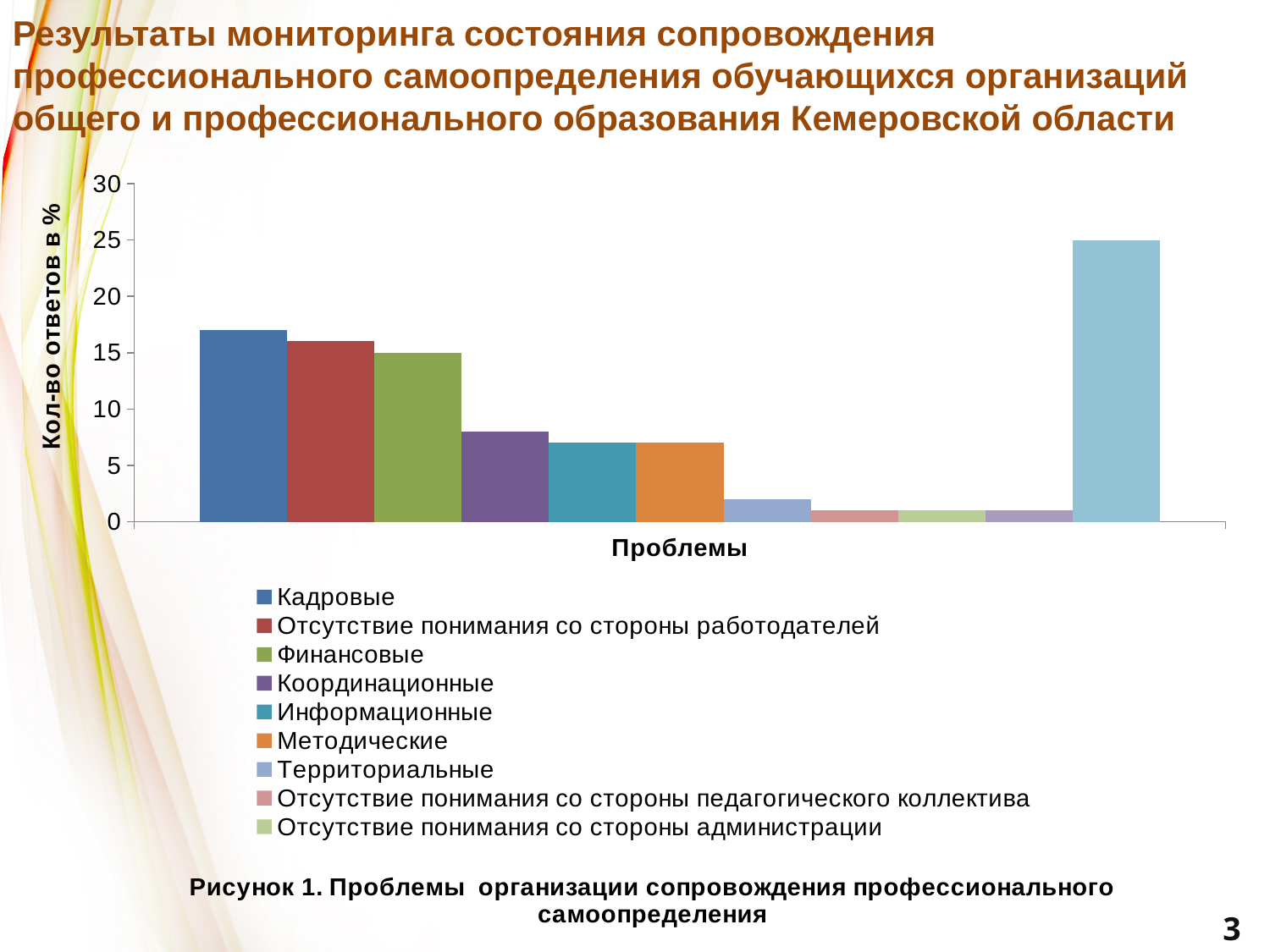
How many bars are plotted in the chart? 11 Which is larger, the value for Кадровые or the value for Координационные? Кадровые Is the value for Территориальные greater or less than 5? less Which is larger, the value for Территориальные or the value for Методические? Методические Is the value for Кадровые greater or less than 20? less Is the value for Координационные greater or less than 10? less What is the title of the vertical axis of the chart? Кол-во ответов в % What kind of chart is shown on the slide? bar chart How many entries does the chart legend list? 9